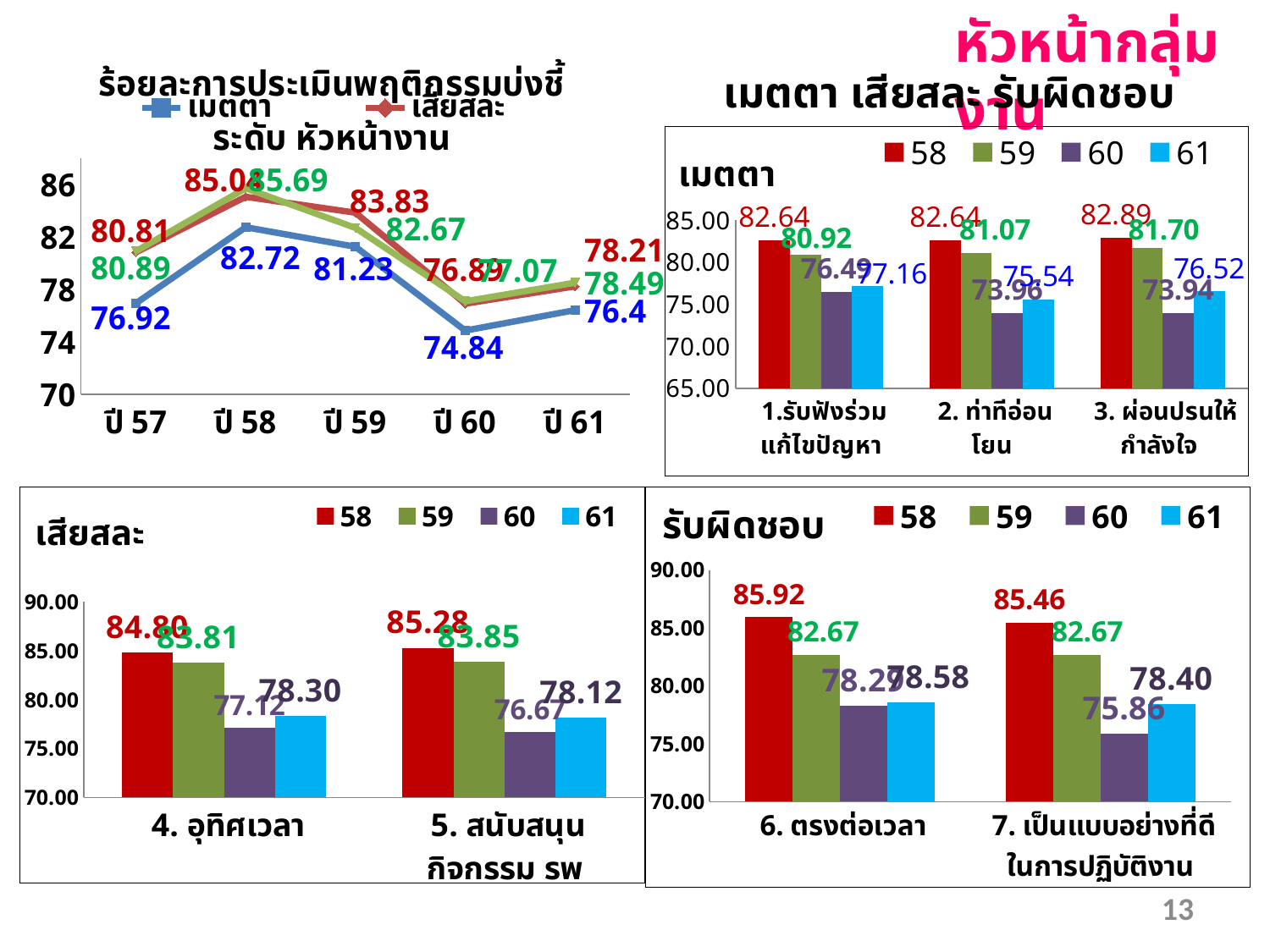
In the เสียสละ bar chart, which is larger in category 5. สนับสนุนกิจกรรม รพ: series 58 or series 59? 58 In the line chart titled ร้อยละการประเมินพฤติกรรมบ่งชี้ ระดับ หัวหน้างาน, in which year is เมตตา highest? ปี 58 How many categories are shown on the x axis of the เสียสละ bar chart? 2 In the รับผิดชอบ bar chart, what is the value for series 60 in category 7. เป็นแบบอย่างที่ดีในการปฏิบัติงาน? 75.86 In the เมตตา bar chart, what is the value for series 60 in category 2. ท่าทีอ่อนโยน? 73.96 What kind of chart is the chart titled ร้อยละการประเมินพฤติกรรมบ่งชี้ ระดับ หัวหน้างาน? line chart In the เสียสละ bar chart, what is the value for series 61 in category 4. อุทิศเวลา? 78.30 In the รับผิดชอบ bar chart, what is the difference between series 58 and series 59 in category 6. ตรงต่อเวลา? 3.25 In the เมตตา bar chart, what is the value for series 58 in category 3. ผ่อนปรนให้กำลังใจ? 82.89 In the line chart titled ร้อยละการประเมินพฤติกรรมบ่งชี้ ระดับ หัวหน้างาน, what is the value of เมตตา in ปี 60? 74.84 How many series does the legend of the เมตตา bar chart list? 4 In the รับผิดชอบ bar chart, what is the value for series 58 in category 6. ตรงต่อเวลา? 85.92